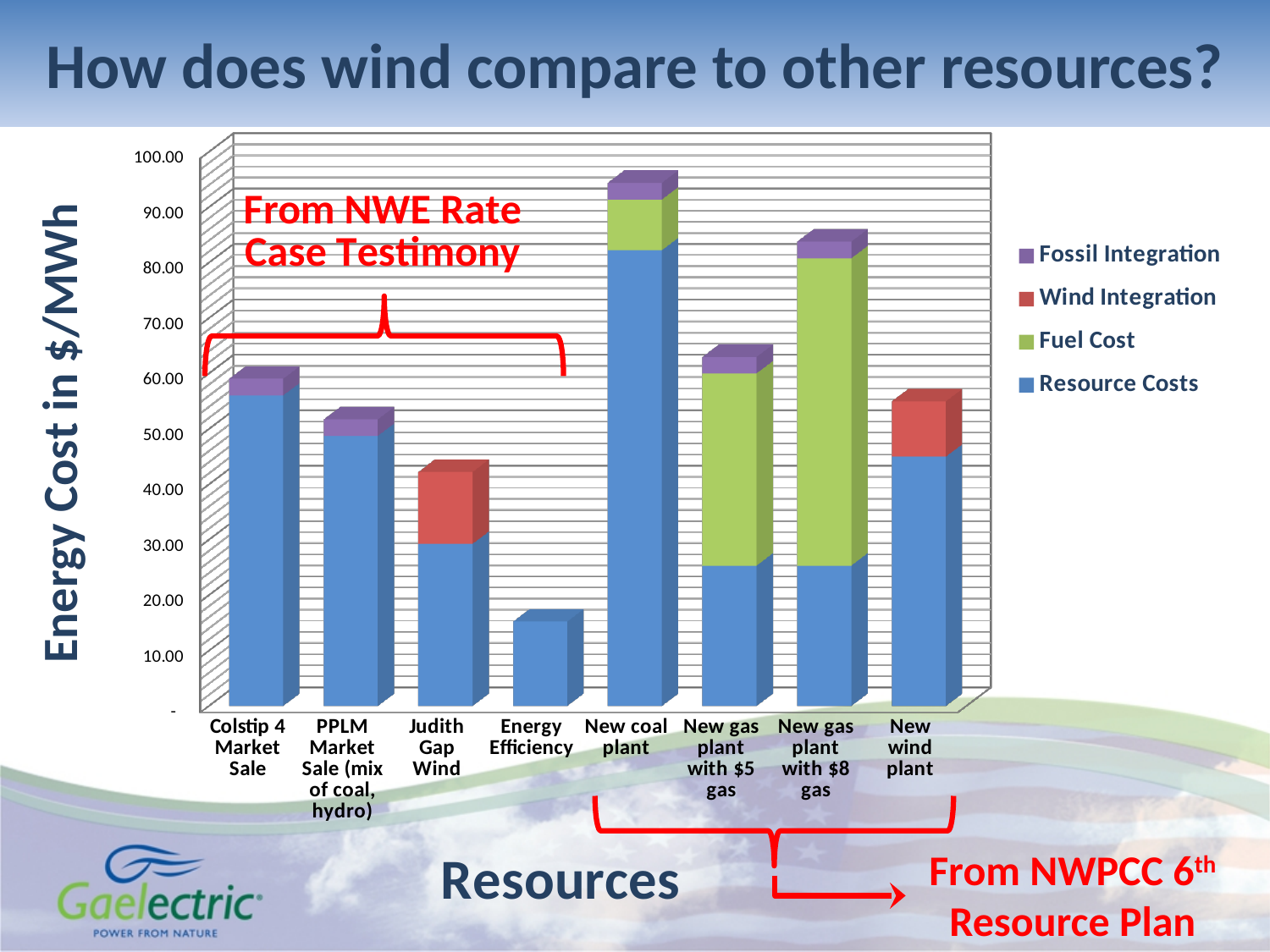
Is the total value for New coal plant greater or less than 90.00? greater Which resource has the highest total energy cost? New coal plant Which has the larger total energy cost, New coal plant or New wind plant? New coal plant Is the total value for New gas plant with $8 gas greater or less than 80.00? greater How many resource categories are shown on the x axis? 8 Is the total value for Judith Gap Wind greater or less than 50.00? less Which has the larger total energy cost, New gas plant with $5 gas or New gas plant with $8 gas? New gas plant with $8 gas How many series does the legend list? 4 What kind of chart is shown on the slide? Stacked bar chart What is the title of the vertical axis? Energy Cost in $/MWh Which resource has the lowest total energy cost? Energy Efficiency